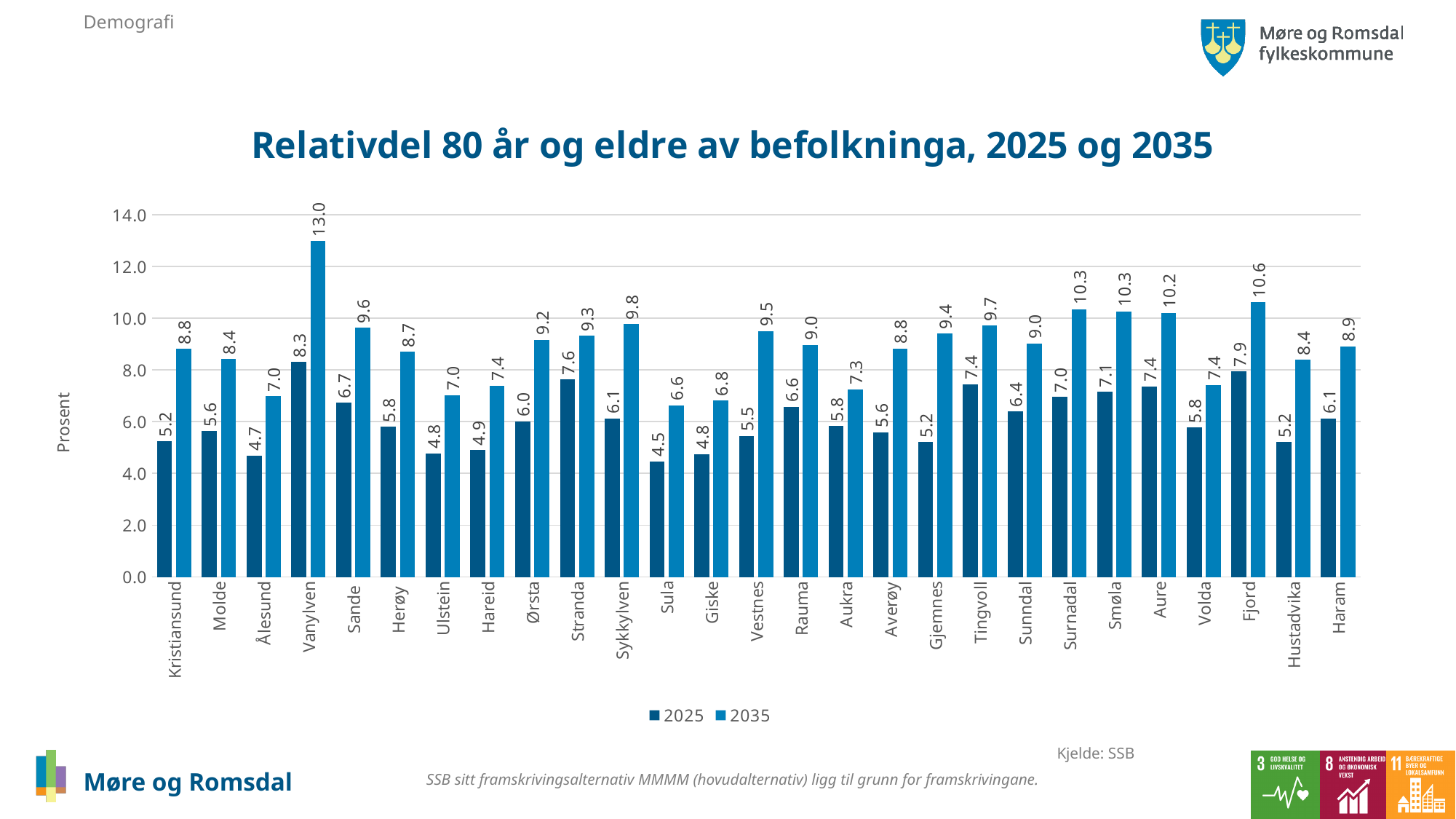
What is the difference between the 2035 and 2025 values for Kristiansund? 3.6 What kind of chart is shown? Bar chart Which municipality has the lowest 2025 value? Sula What is the 2035 value for Vanylven? 13.0 Is the 2035 value for Fjord greater or less than 10.0? greater Which is larger: the 2025 value for Stranda or the 2025 value for Molde? Stranda What is the 2035 value for Vestnes? 9.5 How many series does the legend list? 2 What is the title of the chart? Relativdel 80 år og eldre av befolkninga, 2025 og 2035 Which municipality has the highest 2035 value? Vanylven How many municipalities are shown on the x axis? 27 What is the 2025 value for Fjord? 7.9